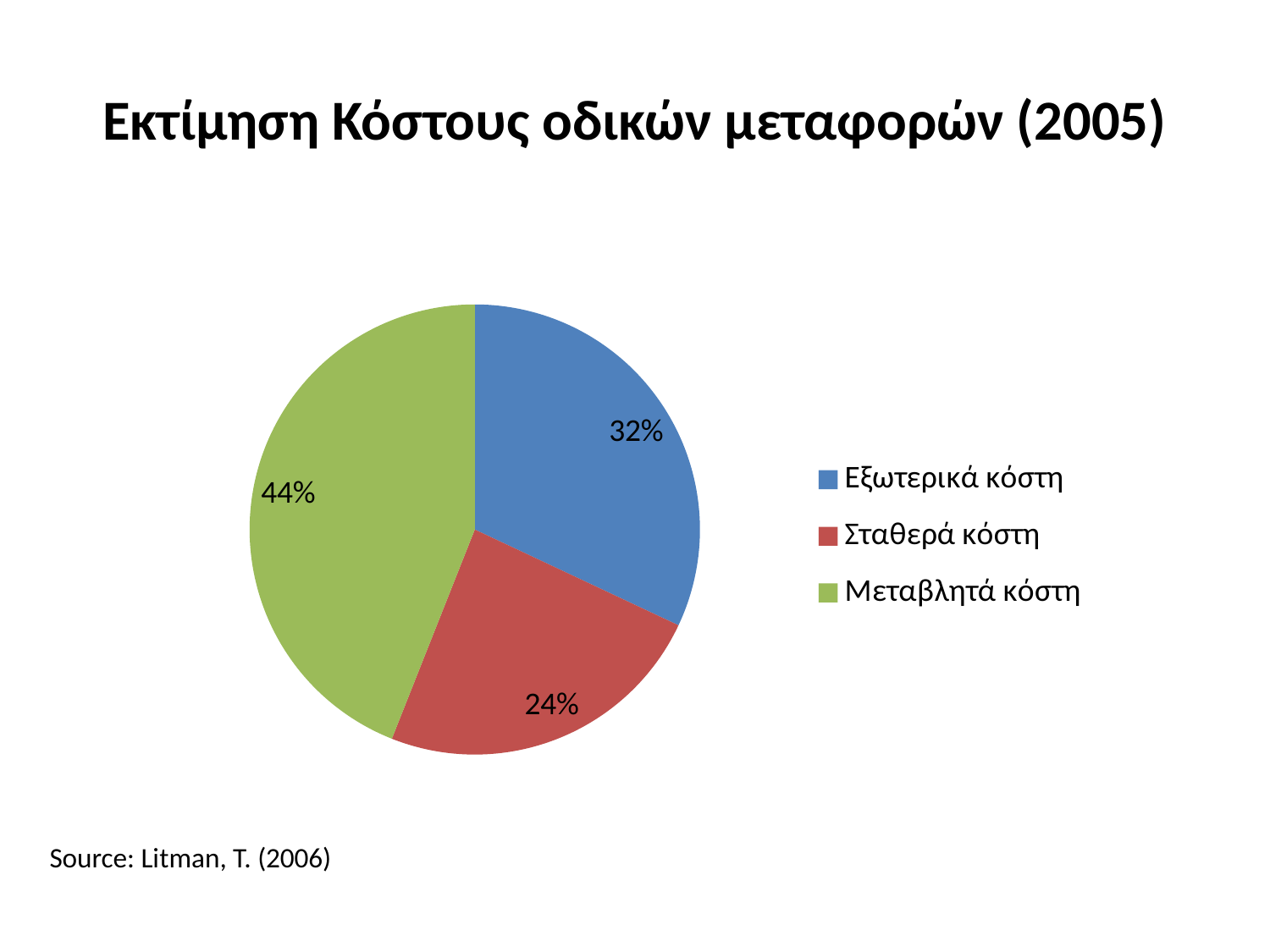
Which category has the largest slice of the pie? Μεταβλητά κόστη What share of the pie does Σταθερά κόστη represent? 24% What is the title of the chart on the slide? Εκτίμηση Κόστους οδικών μεταφορών (2005) Which colour represents Σταθερά κόστη in the legend? Red What is the difference in percentage points between Μεταβλητά κόστη and Σταθερά κόστη? 20 percentage points What share of the pie does Μεταβλητά κόστη represent? 44% Which is larger, the slice for Εξωτερικά κόστη or the slice for Σταθερά κόστη? Εξωτερικά κόστη What share of the pie does Εξωτερικά κόστη represent? 32% What is the difference in percentage points between Εξωτερικά κόστη and Σταθερά κόστη? 8 percentage points What kind of chart is shown on the slide? Pie chart How many categories are shown in the pie chart? 3 Which category has the smallest slice of the pie? Σταθερά κόστη